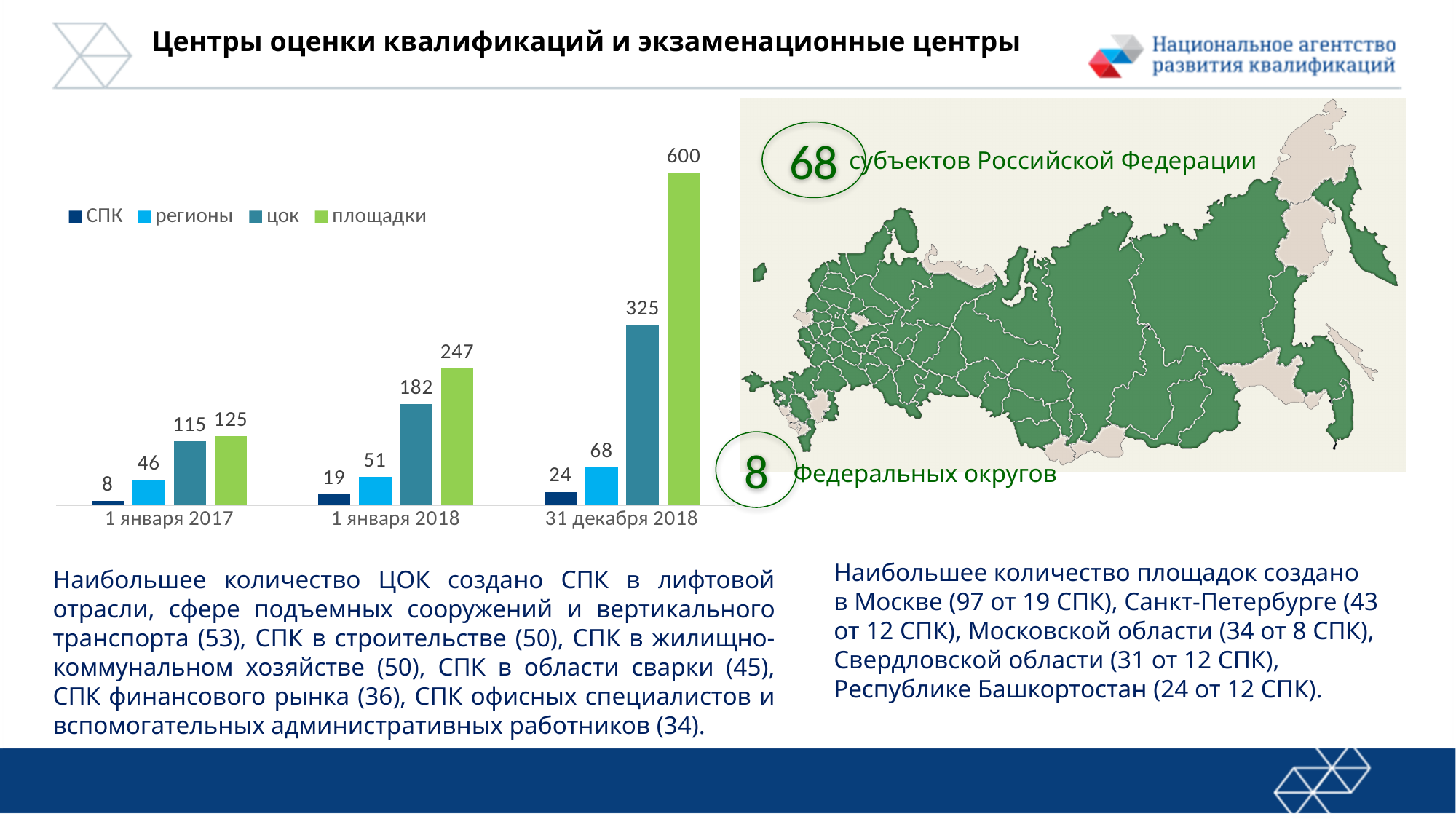
Which date has the highest value for площадки? 31 декабря 2018 What kind of chart is shown on the slide? bar chart What is the value for СПК on 1 января 2017? 8 What is the difference between the площадки values on 31 декабря 2018 and 1 января 2018? 353 Which is larger on 1 января 2017: the value for ЦОК or the value for площадки? площадки How many series does the chart legend list? 4 Which series has the lowest value on 1 января 2018? СПК Do the values for ЦОК rise or fall from 1 января 2017 to 31 декабря 2018? rise How many dates are shown on the x axis of the chart? 3 What is the value for площадки on 31 декабря 2018? 600 What is the value for ЦОК on 1 января 2018? 182 What is the value for регионы on 31 декабря 2018? 68